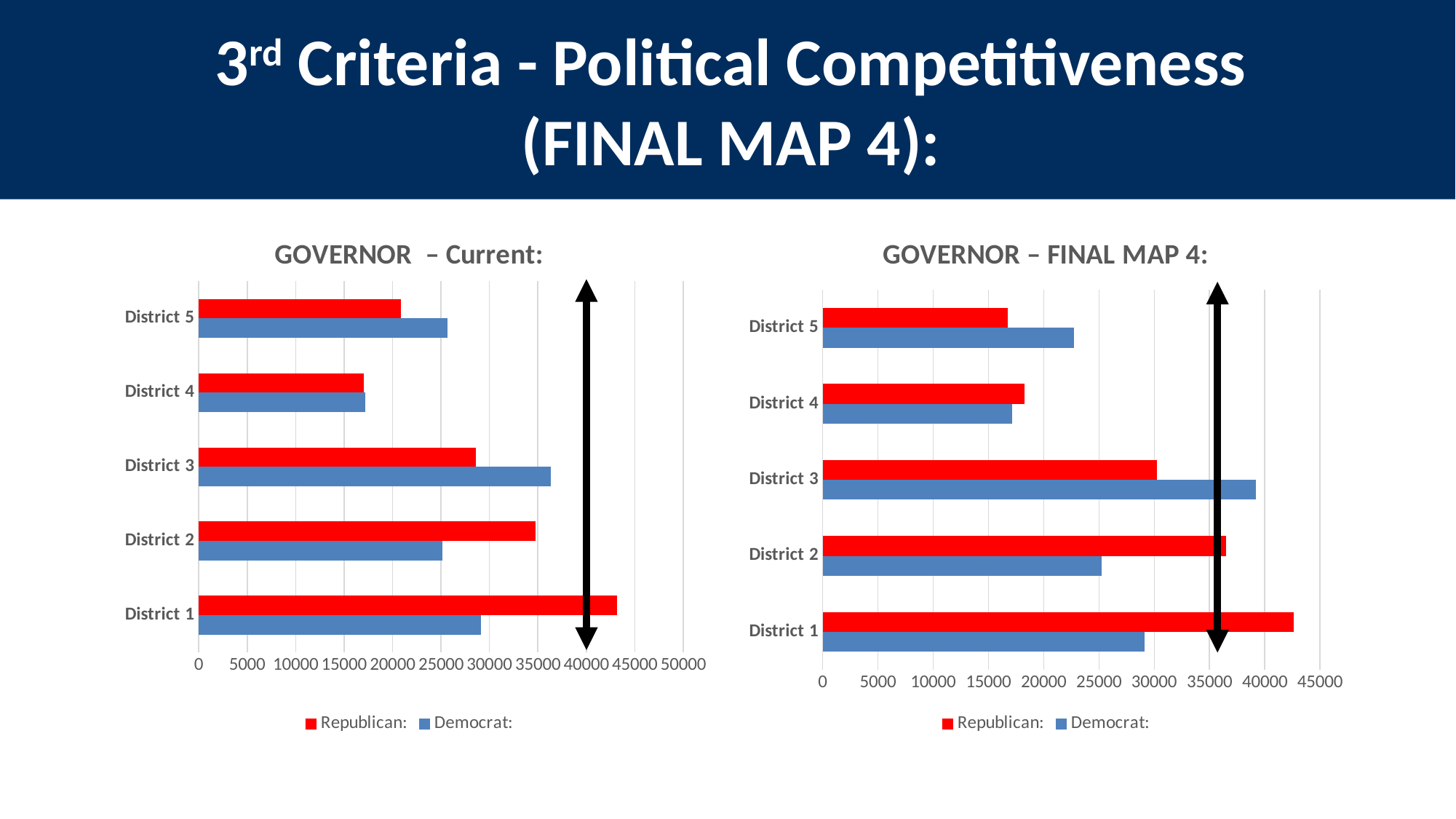
What kind of chart is the 'GOVERNOR – Current:' chart? bar chart On the 'GOVERNOR – FINAL MAP 4:' chart, is the Democrat value for District 3 greater or less than 35000? greater How many series does the legend of the 'GOVERNOR – Current:' chart list? 2 What colour are the Democrat bars on the 'GOVERNOR – FINAL MAP 4:' chart? blue On the 'GOVERNOR – Current:' chart, which district has the highest Democrat value? District 3 On the 'GOVERNOR – FINAL MAP 4:' chart, is the Democrat value for District 5 greater or less than 25000? less How many districts are shown on the 'GOVERNOR – FINAL MAP 4:' chart? 5 On the 'GOVERNOR – Current:' chart, is the Republican value for District 1 greater or less than 40000? greater On the 'GOVERNOR – FINAL MAP 4:' chart, which district has the lowest Republican value? District 5 On the 'GOVERNOR – Current:' chart, in District 3, which is larger: the Republican value or the Democrat value? Democrat On the 'GOVERNOR – Current:' chart, which district has the highest Republican value? District 1 On the 'GOVERNOR – FINAL MAP 4:' chart, in District 2, which is larger: the Republican value or the Democrat value? Republican